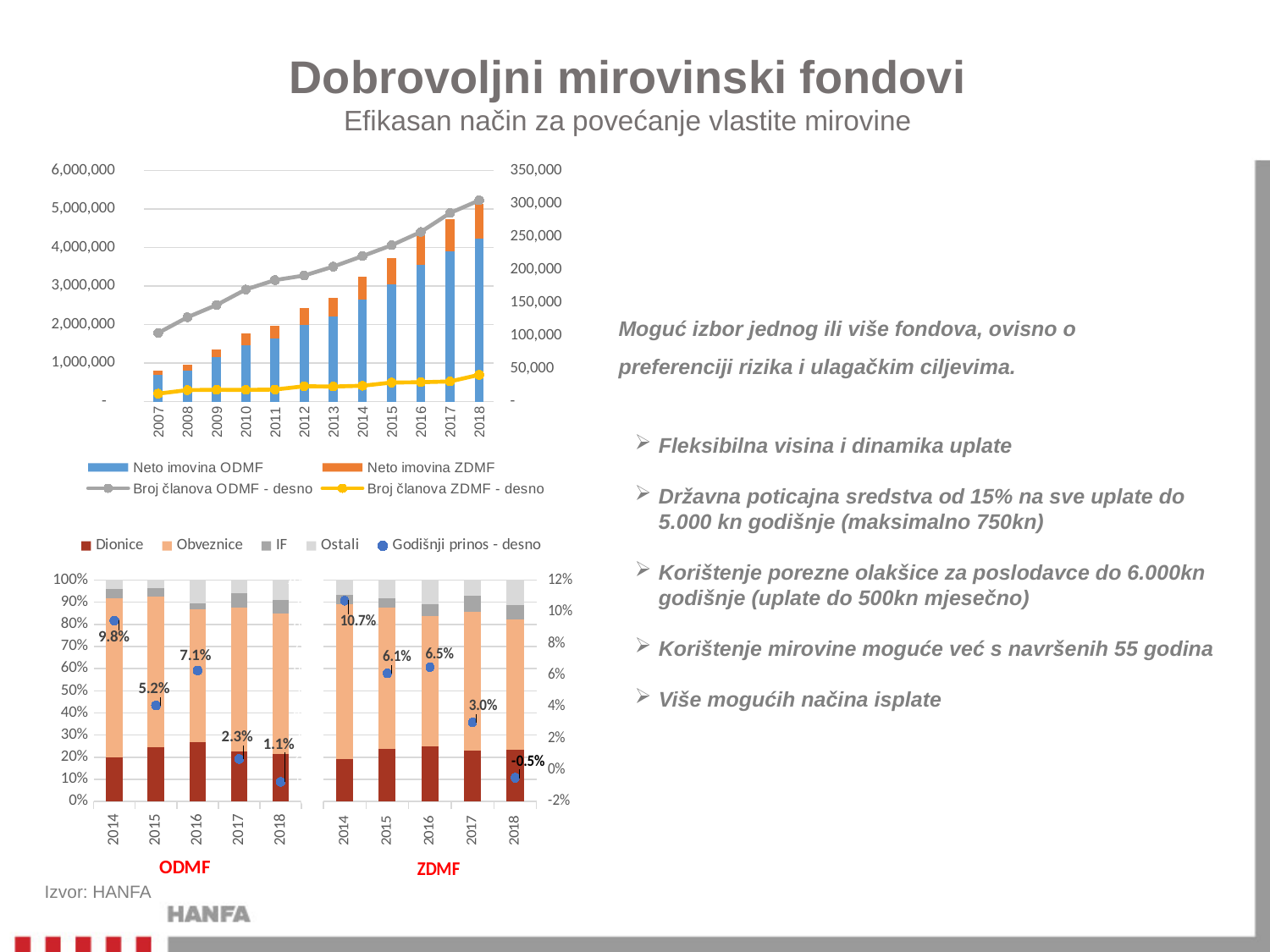
In the bottom chart, what is the Godišnji prinos for ODMF in 2014? 9.8% In the top chart, is the value of Broj članova ZDMF in 2018 greater or less than 50,000? less In the bottom chart, which year has the lowest Godišnji prinos for ODMF? 2018 In the bottom chart, does the Godišnji prinos for ODMF generally rise or fall from 2014 to 2018? fall How many years are shown on the x axis of the top chart? 12 In the bottom chart, what is the Godišnji prinos for ZDMF in 2018? -0.5% In the top chart, is the value of Broj članova ODMF in 2018 greater or less than 250,000? greater In the bottom chart, which had the higher Godišnji prinos in 2016, ODMF or ZDMF? ODMF In the top chart, does Broj članova ODMF rise or fall from 2007 to 2018? rise In the bottom chart, what is the difference between the 2014 Godišnji prinos for ZDMF and for ODMF? 0.9 percentage points In the bottom chart, which year has the highest Godišnji prinos for ZDMF? 2014 How many series does the legend of the bottom chart list? 5